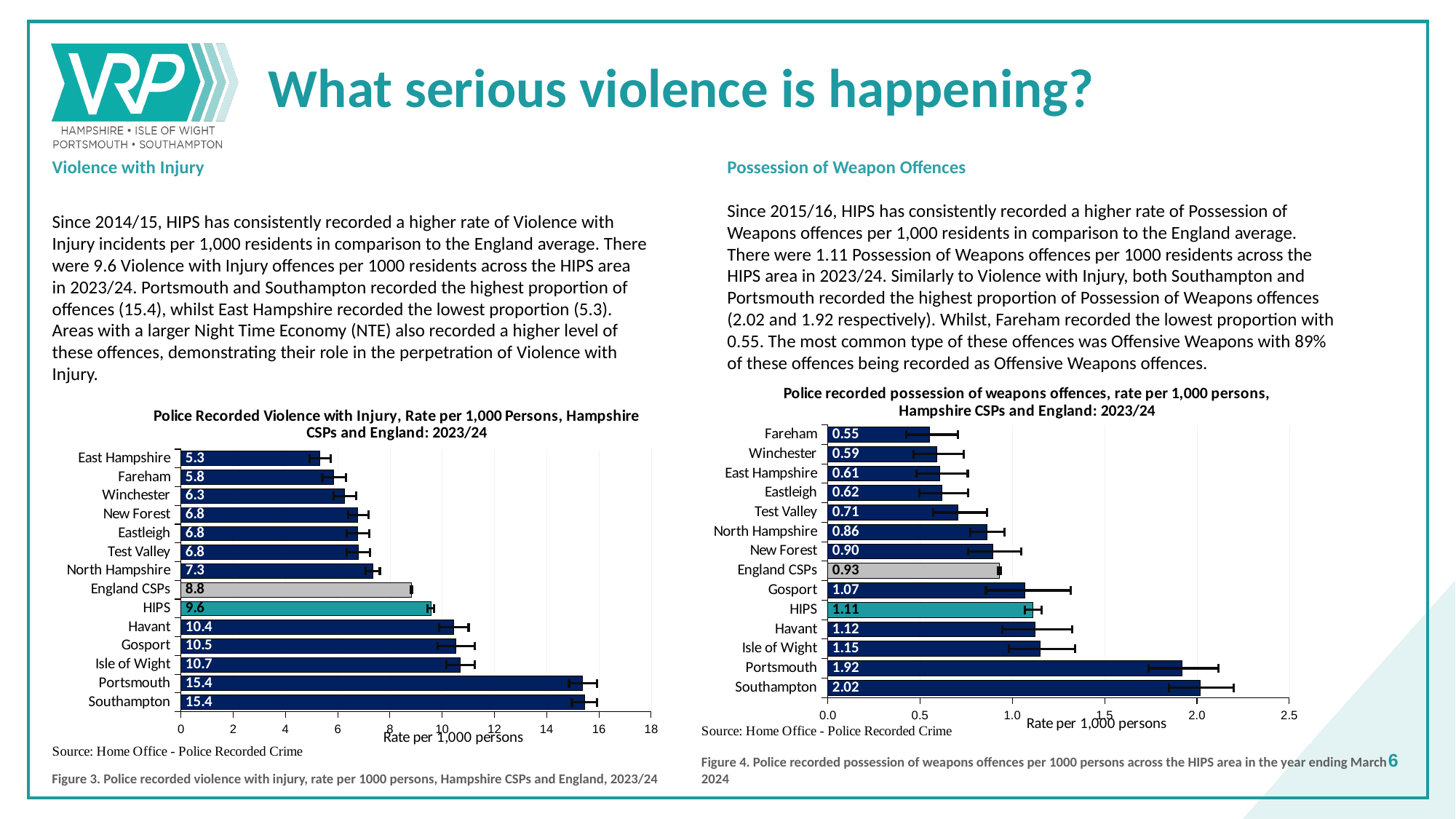
In the Possession of Weapon Offences chart on the right, which area has the highest rate? Southampton In the Violence with Injury chart on the left, what is the rate per 1,000 persons for HIPS? 9.6 In the Violence with Injury chart on the left, what is the rate per 1,000 persons for England CSPs? 8.8 In the Violence with Injury chart on the left, what is the difference between the rates for Isle of Wight and Fareham? 4.9 In the Violence with Injury chart on the left, which area has the lowest rate? East Hampshire What type of chart is used for the Possession of Weapon Offences chart on the right? Bar chart In the Possession of Weapon Offences chart on the right, which area has the lowest rate? Fareham In the Possession of Weapon Offences chart on the right, what is the rate per 1,000 persons for Portsmouth? 1.92 In the Possession of Weapon Offences chart on the right, what is the difference between the rates for HIPS and England CSPs? 0.18 In the Violence with Injury chart on the left, is the rate for Havant greater or less than 10? greater In the Violence with Injury chart on the left, how many bars are plotted? 14 In the Possession of Weapon Offences chart on the right, which is larger, the rate for Gosport or the rate for New Forest? Gosport